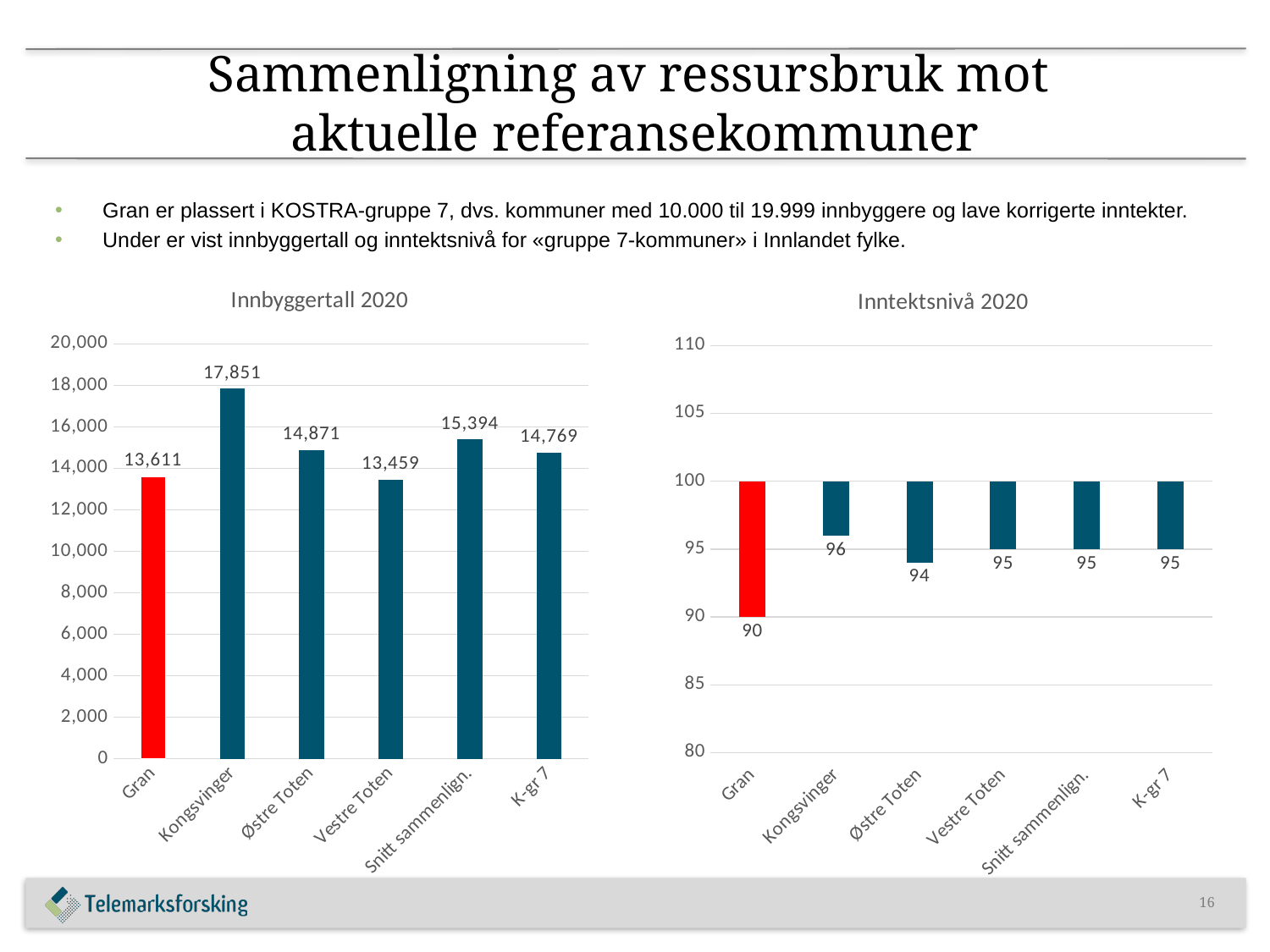
In the 'Innbyggertall 2020' chart, which category has the highest value? Kongsvinger In the 'Inntektsnivå 2020' chart, what is the difference between Kongsvinger and Gran? 6 In the 'Innbyggertall 2020' chart, what is the value for Gran? 13,611 In the 'Inntektsnivå 2020' chart, what is the value for Gran? 90 How many categories are shown in the 'Inntektsnivå 2020' chart? 6 In the 'Innbyggertall 2020' chart, which category has the lowest value? Vestre Toten In the 'Inntektsnivå 2020' chart, which category has the highest value? Kongsvinger What type of chart is the 'Innbyggertall 2020' chart? Bar chart In the 'Innbyggertall 2020' chart, which is larger: Østre Toten or Snitt sammenlign.? Snitt sammenlign. In the 'Innbyggertall 2020' chart, what is the value for Kongsvinger? 17,851 In the 'Inntektsnivå 2020' chart, what is the value for Østre Toten? 94 In the 'Innbyggertall 2020' chart, what is the difference between Kongsvinger and Gran? 4,240